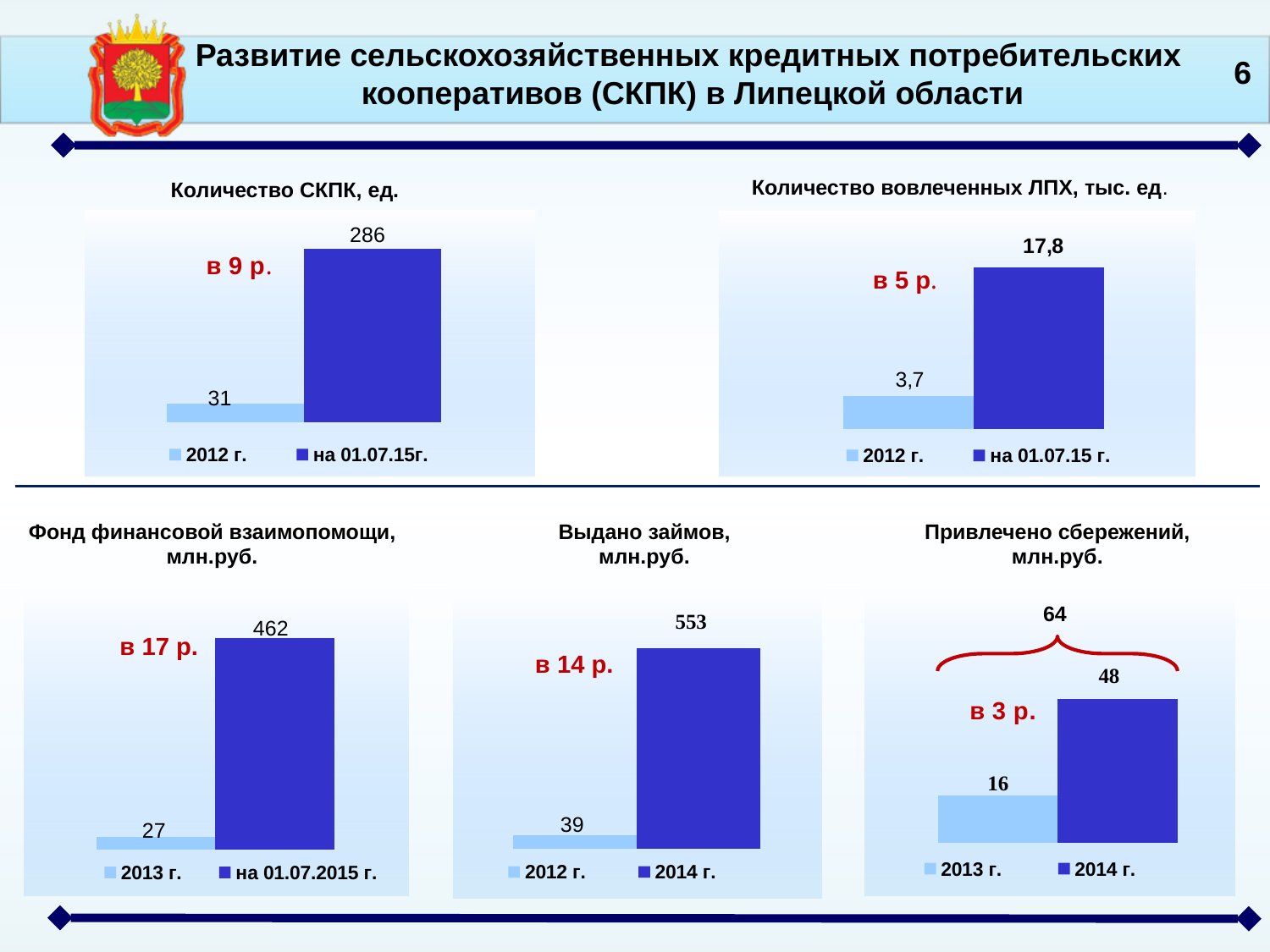
In the chart titled "Привлечено сбережений, млн.руб.", what is the value for "2013 г."? 16 In the chart titled "Количество СКПК, ед.", what is the value for "на 01.07.15г."? 286 In the chart titled "Выдано займов, млн.руб.", what is the value for "2014 г."? 553 In the chart titled "Фонд финансовой взаимопомощи, млн.руб.", which series has the higher value, "2013 г." or "на 01.07.2015 г."? на 01.07.2015 г. In the chart titled "Выдано займов, млн.руб.", what is the difference between the "2014 г." value and the "2012 г." value? 514 In the chart titled "Количество вовлеченных ЛПХ, тыс. ед.", what is the difference between the "на 01.07.15 г." value and the "2012 г." value? 14,1 In the chart titled "Фонд финансовой взаимопомощи, млн.руб.", what is the value for "2013 г."? 27 In the chart titled "Количество вовлеченных ЛПХ, тыс. ед.", what is the value for "на 01.07.15 г."? 17,8 In the chart titled "Количество СКПК, ед.", what is the value for "2012 г."? 31 What kind of chart is the chart titled "Выдано займов, млн.руб."? Bar chart In the chart titled "Привлечено сбережений, млн.руб.", what is the combined total of the "2013 г." and "2014 г." values shown above the bracket? 64 How many series does the legend list in the chart titled "Количество СКПК, ед."? 2